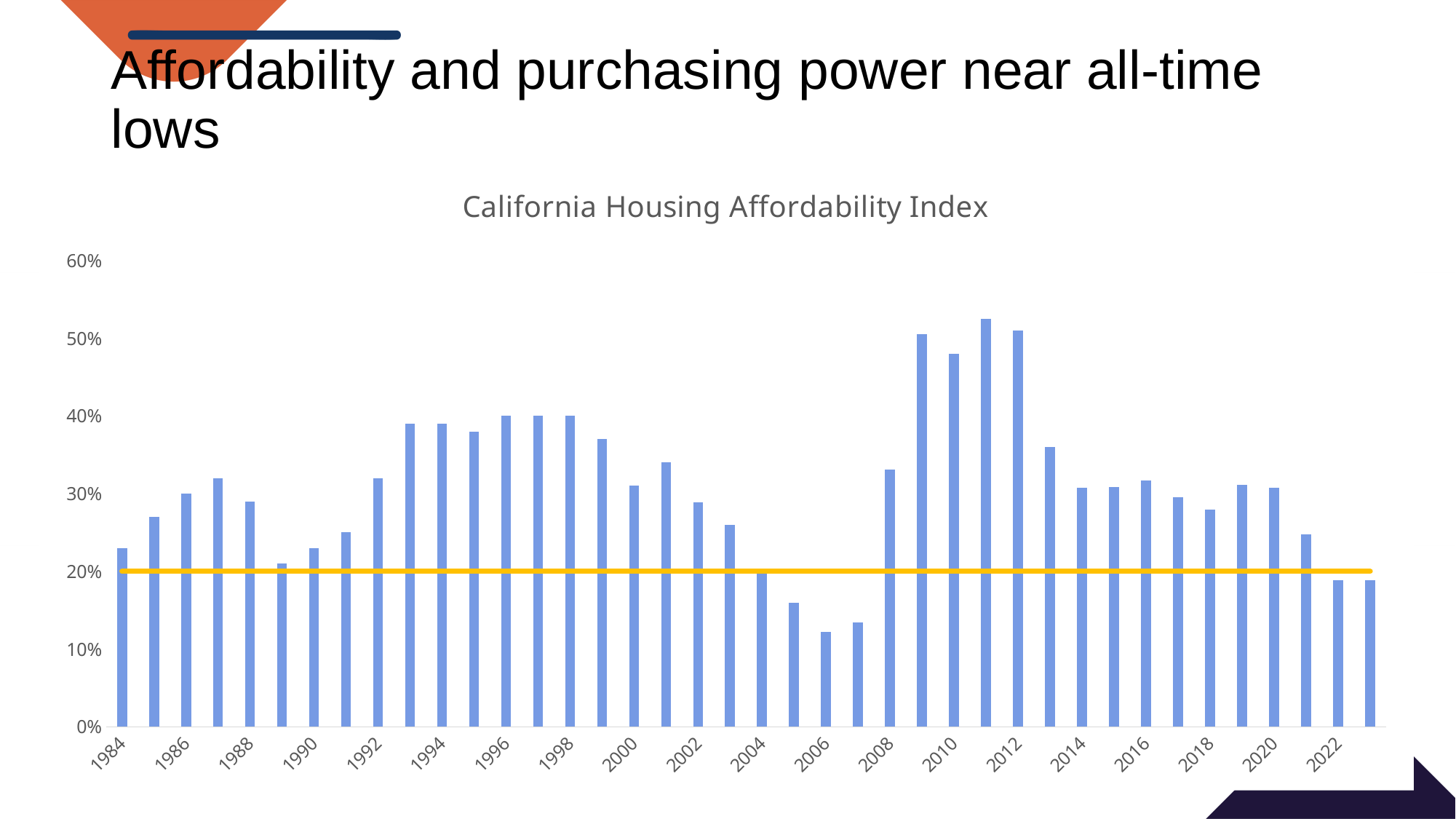
Which year has the highest value in the California Housing Affordability Index chart? 2011 Is the value for 2005 greater or less than 20%? less Which is larger, the value for 1984 or the value for 1987? 1987 Which is larger, the value for 2009 or the value for 2004? 2009 At what level is the horizontal reference line drawn on the chart? 20% Is the value for 2006 greater or less than 20%? less What is the title of the chart? California Housing Affordability Index Which year has the lowest value in the California Housing Affordability Index chart? 2006 What kind of chart is shown on the slide? bar chart Do the values rise or fall from 2003 to 2006? fall Is the value for 2011 greater or less than 50%? greater